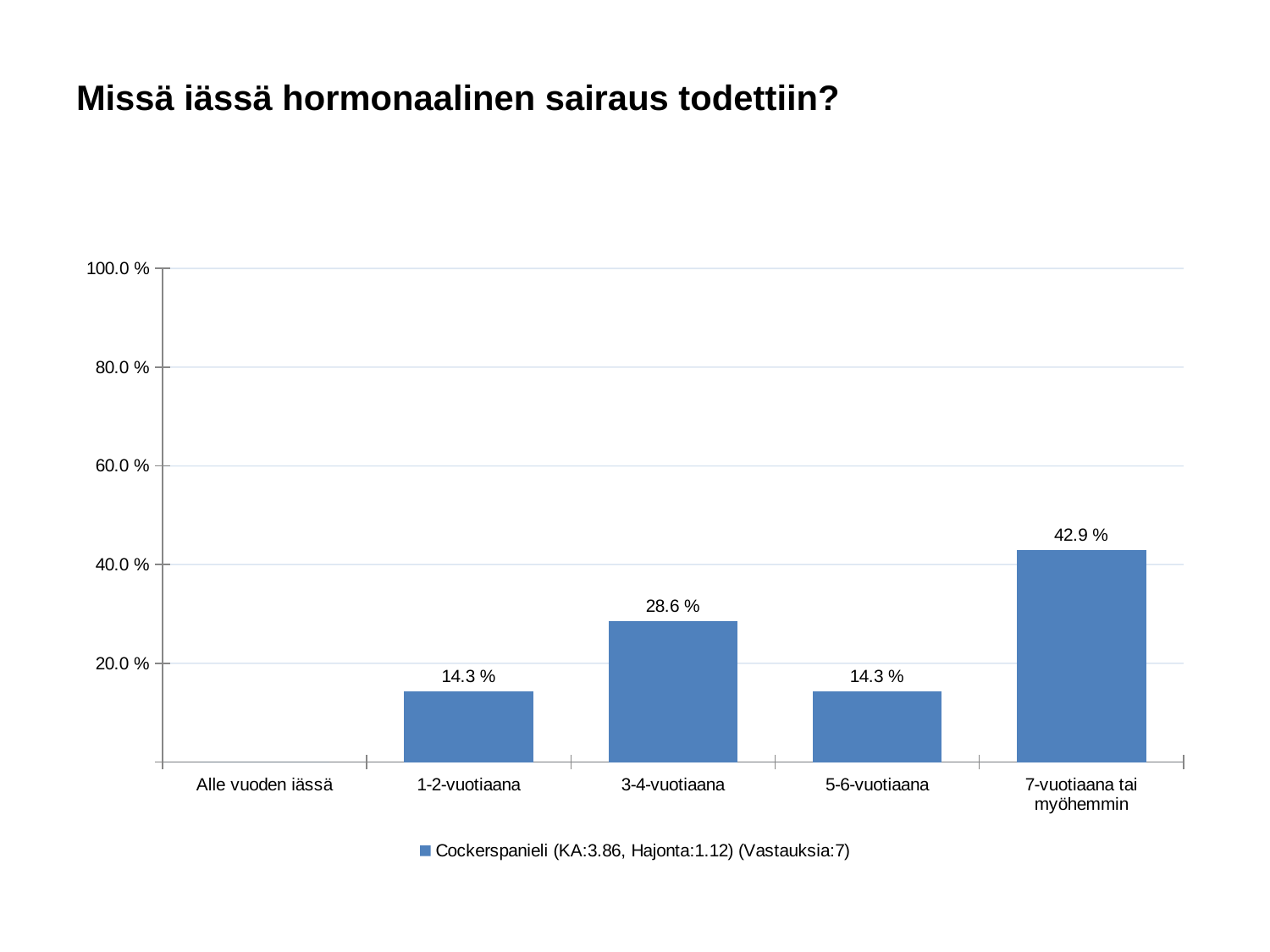
What is the difference between the values for 7-vuotiaana tai myöhemmin and 3-4-vuotiaana? 14.3 % What is the title of the slide? Missä iässä hormonaalinen sairaus todettiin? What is the legend entry for the series? Cockerspanieli (KA:3.86, Hajonta:1.12) (Vastauksia:7) What is the value for 3-4-vuotiaana? 28.6 % What is the value for 1-2-vuotiaana? 14.3 % Which category has the highest value? 7-vuotiaana tai myöhemmin Is the value for 7-vuotiaana tai myöhemmin greater or less than 40.0 %? greater Which is larger, the value for 3-4-vuotiaana or the value for 5-6-vuotiaana? 3-4-vuotiaana How many categories are shown on the x axis? 5 What is the value for 7-vuotiaana tai myöhemmin? 42.9 % What kind of chart is shown on the slide? bar chart How many series does the legend list? 1